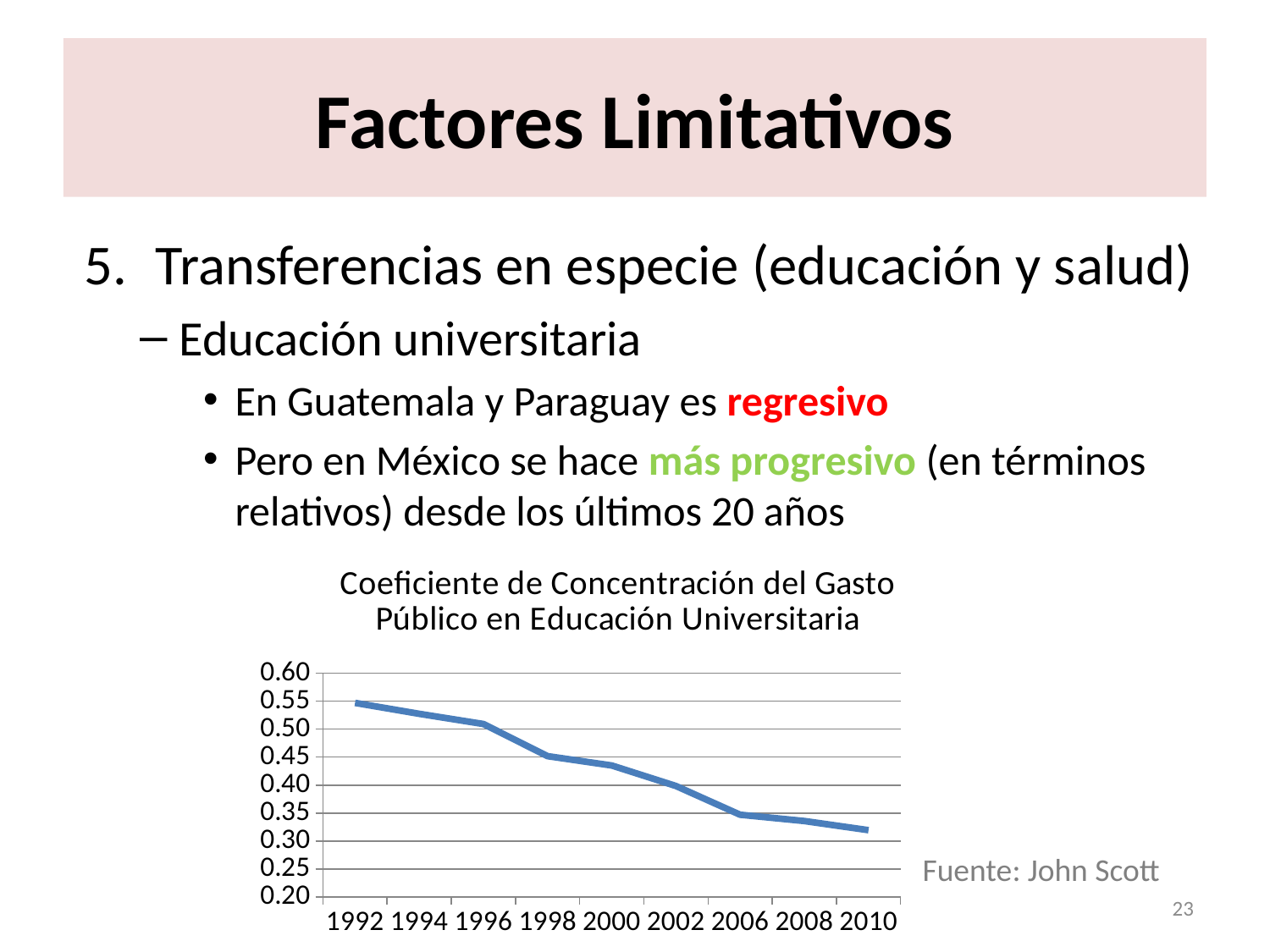
Which year has the lowest value in the chart? 2010 Is the value for 2010 greater or less than 0.30? greater Which year has the highest value in the chart? 1992 How many years are plotted on the x axis of the chart? 9 Is the value for 1992 greater or less than 0.50? greater What kind of chart is shown on the slide? line chart Do the values rise or fall from 1992 to 2010? fall Is the value for 2006 greater or less than 0.40? less Who is cited as the source of the chart? John Scott Which is larger, the value for 1994 or the value for 2008? 1994 What is the title of the chart? Coeficiente de Concentración del Gasto Público en Educación Universitaria